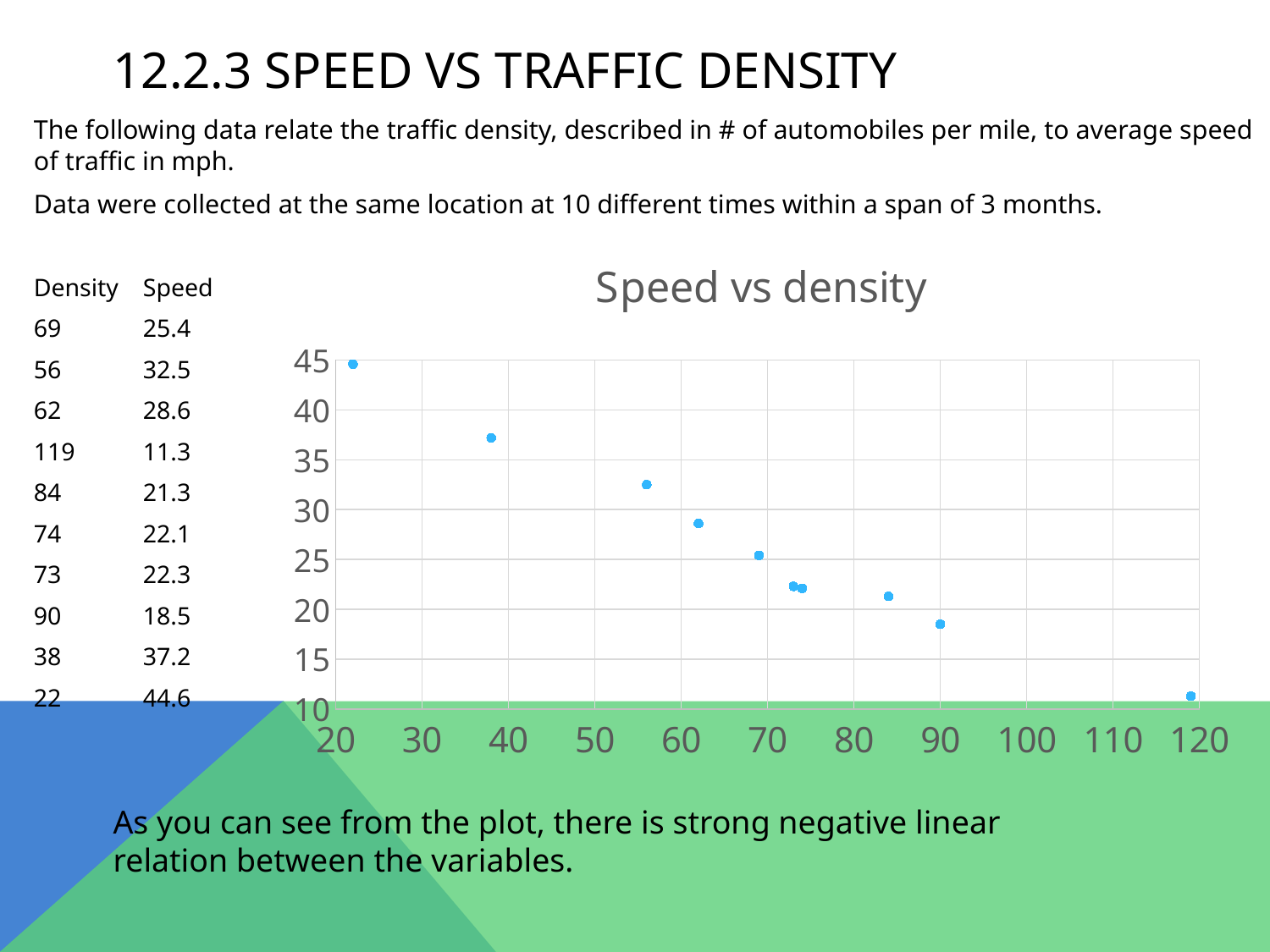
What kind of chart is shown on the slide? scatter chart Is the speed at a density of 84 greater or less than 25? less Which has a higher speed, density 38 or density 56? density 38 What is the title of the chart? Speed vs density What is the difference in speed between density 22 and density 119? 33.3 What is the speed at a density of 119? 11.3 Which density value has the lowest speed? 119 Which density value has the highest speed? 22 As density increases along the x axis, does speed rise or fall? fall How many data points are plotted in the Speed vs density chart? 10 What is the speed at a density of 22? 44.6 What is the speed at a density of 90? 18.5